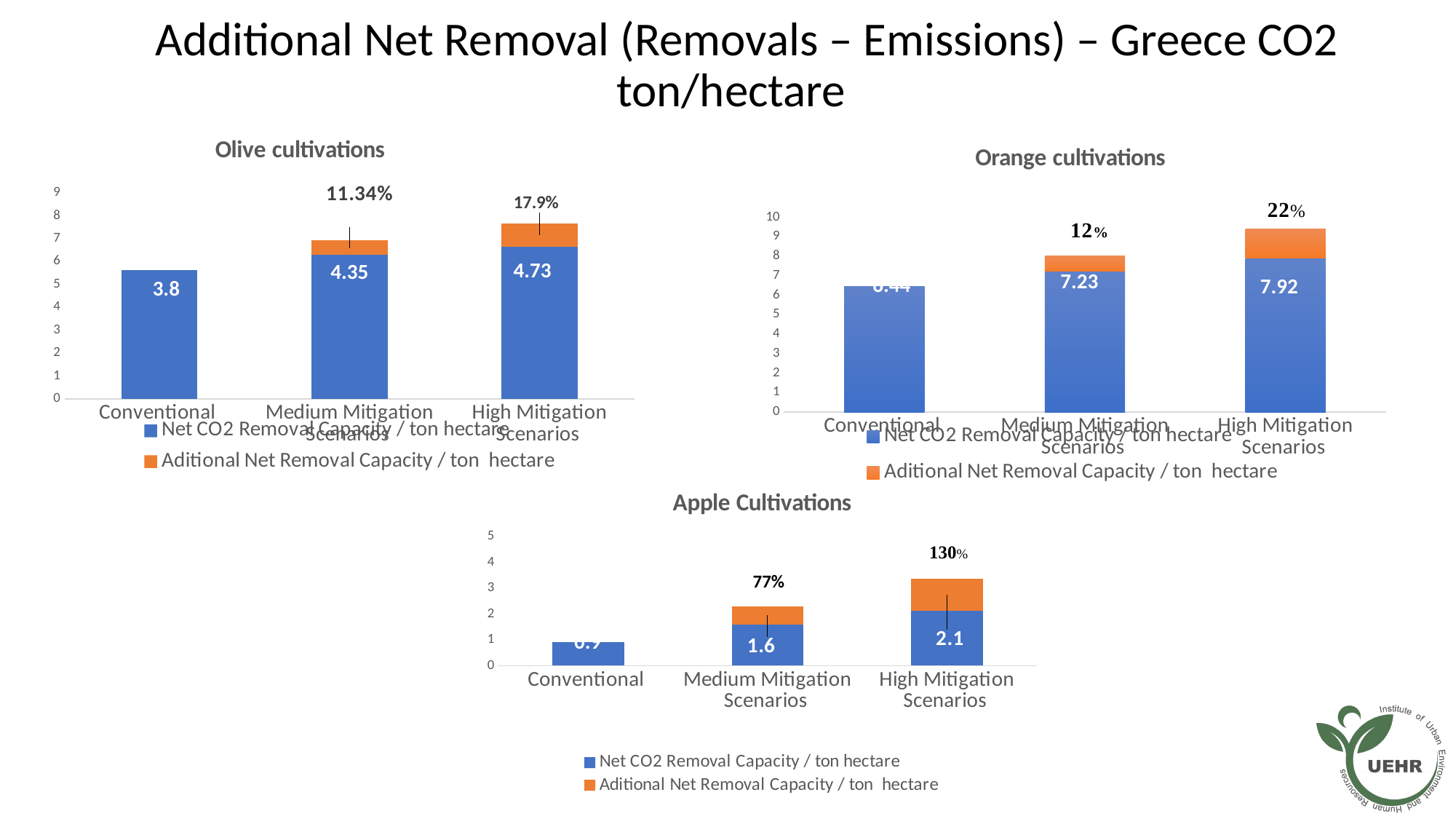
In the Olive cultivations chart, what is the Net CO2 Removal Capacity value for Conventional? 3.8 In the Orange cultivations chart, what is the Net CO2 Removal Capacity value for High Mitigation Scenarios? 7.92 What kind of chart is the Orange cultivations chart? Stacked bar chart In the Olive cultivations chart, what is the Net CO2 Removal Capacity value for Medium Mitigation Scenarios? 4.35 In the Olive cultivations chart, which category has the highest Net CO2 Removal Capacity value? High Mitigation Scenarios In the Apple Cultivations chart, what percentage label is shown above the High Mitigation Scenarios bar? 130% How many series does the legend of the Apple Cultivations chart list? 2 In the Apple Cultivations chart, what is the Net CO2 Removal Capacity value for High Mitigation Scenarios? 2.1 In the Orange cultivations chart, what is the difference between the Net CO2 Removal Capacity values for High Mitigation Scenarios and Medium Mitigation Scenarios? 0.69 In the Apple Cultivations chart, do the Net CO2 Removal Capacity values rise or fall from Conventional to High Mitigation Scenarios? Rise In the Orange cultivations chart, is the Net CO2 Removal Capacity value for Conventional greater or less than 5? greater In the Olive cultivations chart, what is the difference between the Net CO2 Removal Capacity values for High Mitigation Scenarios and Medium Mitigation Scenarios? 0.38